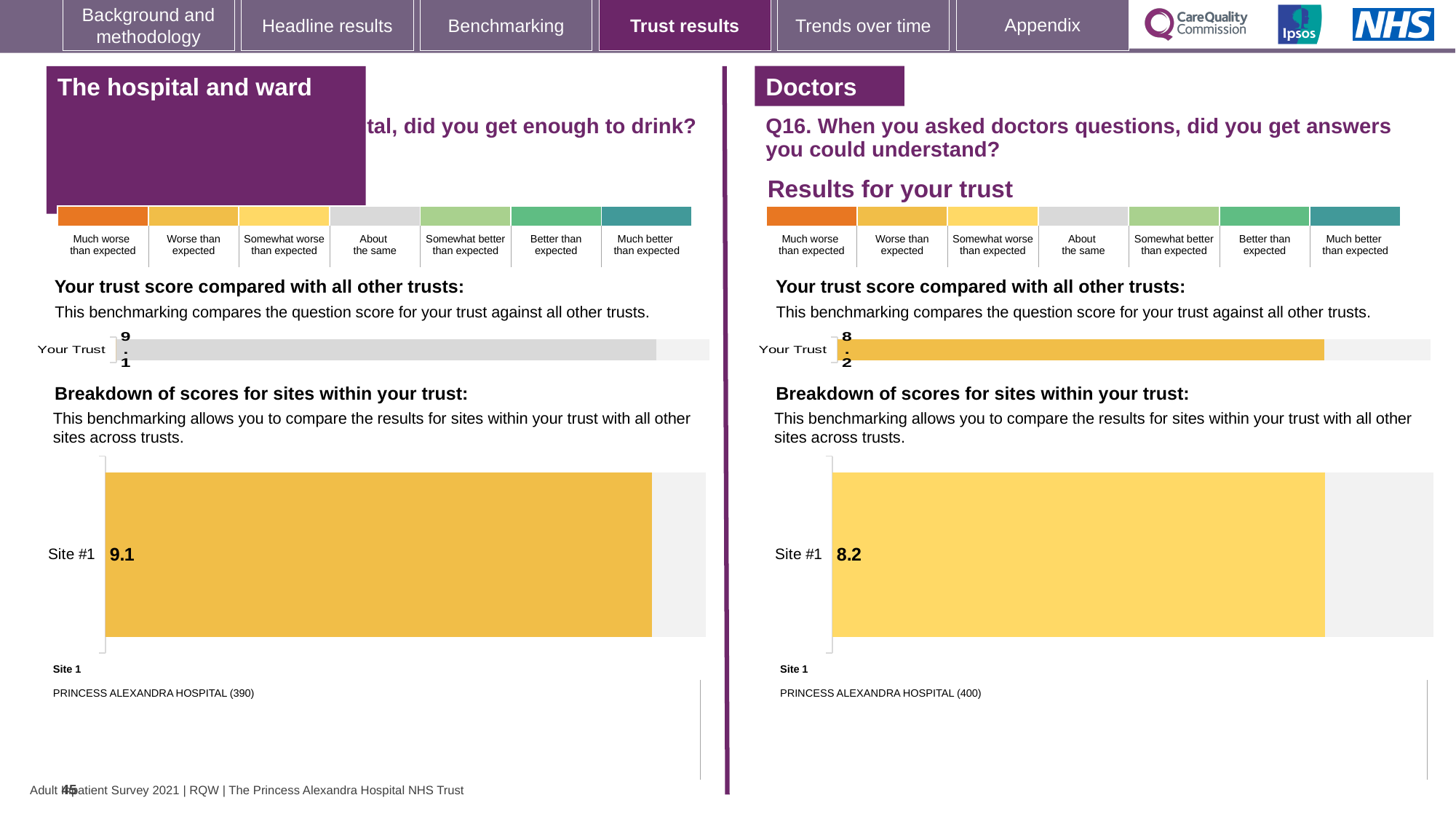
What type of chart is used to show the Site #1 score on the right-hand side (Q16)? Bar chart On the left-hand 'Your trust score compared with all other trusts' chart (The hospital and ward section), what is the score shown for Your Trust? 9.1 How many sites are plotted on the right-hand 'Breakdown of scores for sites within your trust' chart (Q16)? 1 On the right-hand 'Your trust score compared with all other trusts' chart (Doctors, Q16), what is the score shown for Your Trust? 8.2 What is the name of the site labelled Site 1 on the right-hand breakdown chart (Q16)? PRINCESS ALEXANDRA HOSPITAL (400) Is the Your Trust score on the right-hand chart (Doctors, Q16) greater or less than the Your Trust score on the left-hand chart? less What is the name of the site labelled Site 1 on the left-hand breakdown chart (The hospital and ward)? PRINCESS ALEXANDRA HOSPITAL (390) How many sites are plotted on the left-hand 'Breakdown of scores for sites within your trust' chart? 1 Which is larger: the Your Trust score on the left-hand chart (The hospital and ward) or the Your Trust score on the right-hand chart (Doctors, Q16)? The left-hand chart (9.1) On the left-hand 'Breakdown of scores for sites within your trust' chart, what is the score for Site #1? 9.1 On the right-hand 'Breakdown of scores for sites within your trust' chart (Q16), what is the score for Site #1? 8.2 What is the difference between the Site #1 score on the left-hand breakdown chart and the Site #1 score on the right-hand breakdown chart? 0.9